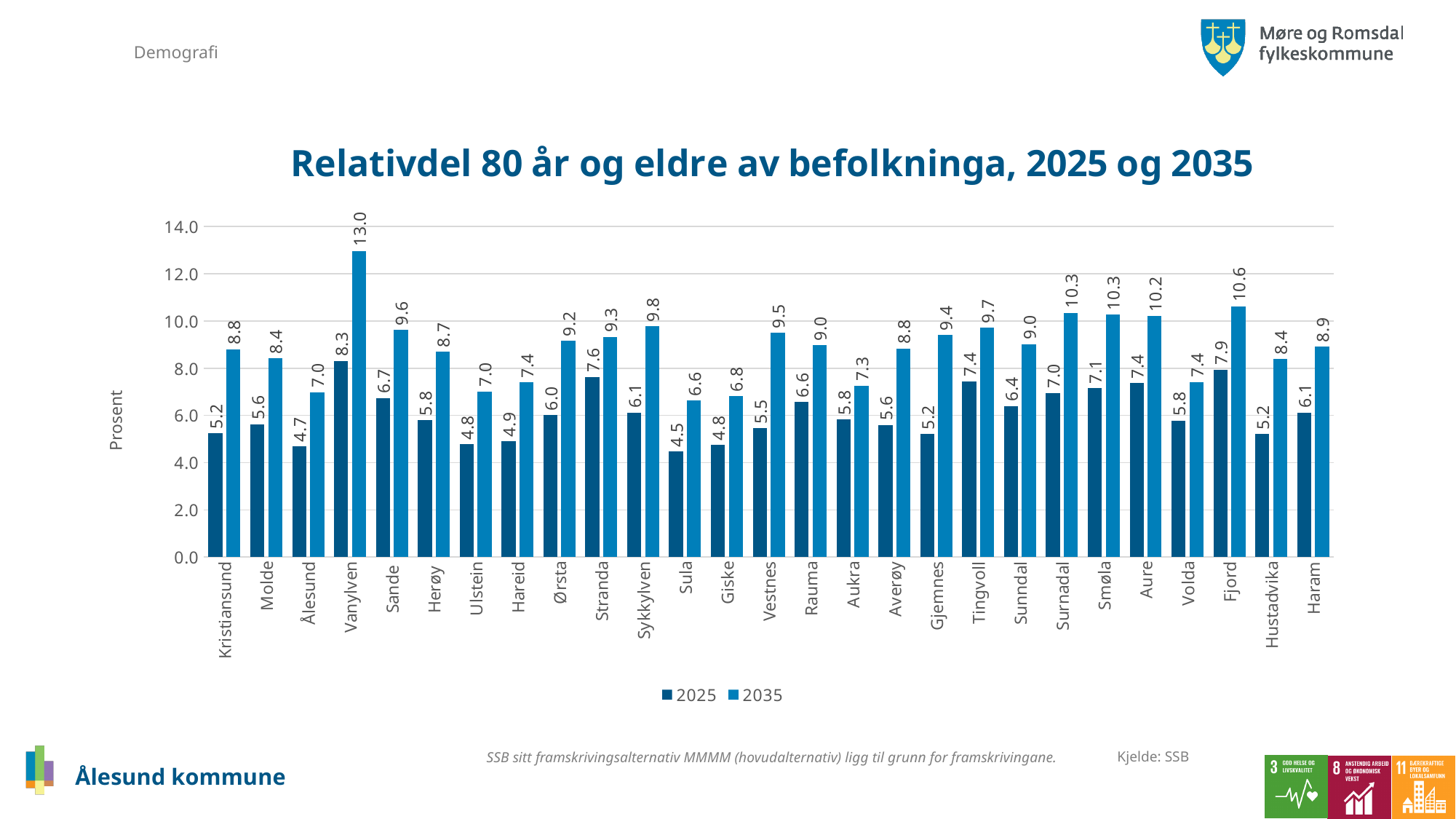
What is the difference between the 2035 and 2025 values for Ålesund? 2.3 Which municipality has the highest 2035 value? Vanylven What is the 2035 value for Vanylven? 13.0 What kind of chart is shown on the slide? Bar chart Which is larger, the 2025 value for Stranda or the 2025 value for Molde? Stranda Which municipality has the lowest 2025 value? Sula How many municipalities are shown on the x axis? 27 How many series does the legend list? 2 What is the difference between the 2035 and 2025 values for Vanylven? 4.7 What is the 2035 value for Fjord? 10.6 What is the 2025 value for Ålesund? 4.7 Is the 2035 value for Surnadal greater or less than 10.0? greater